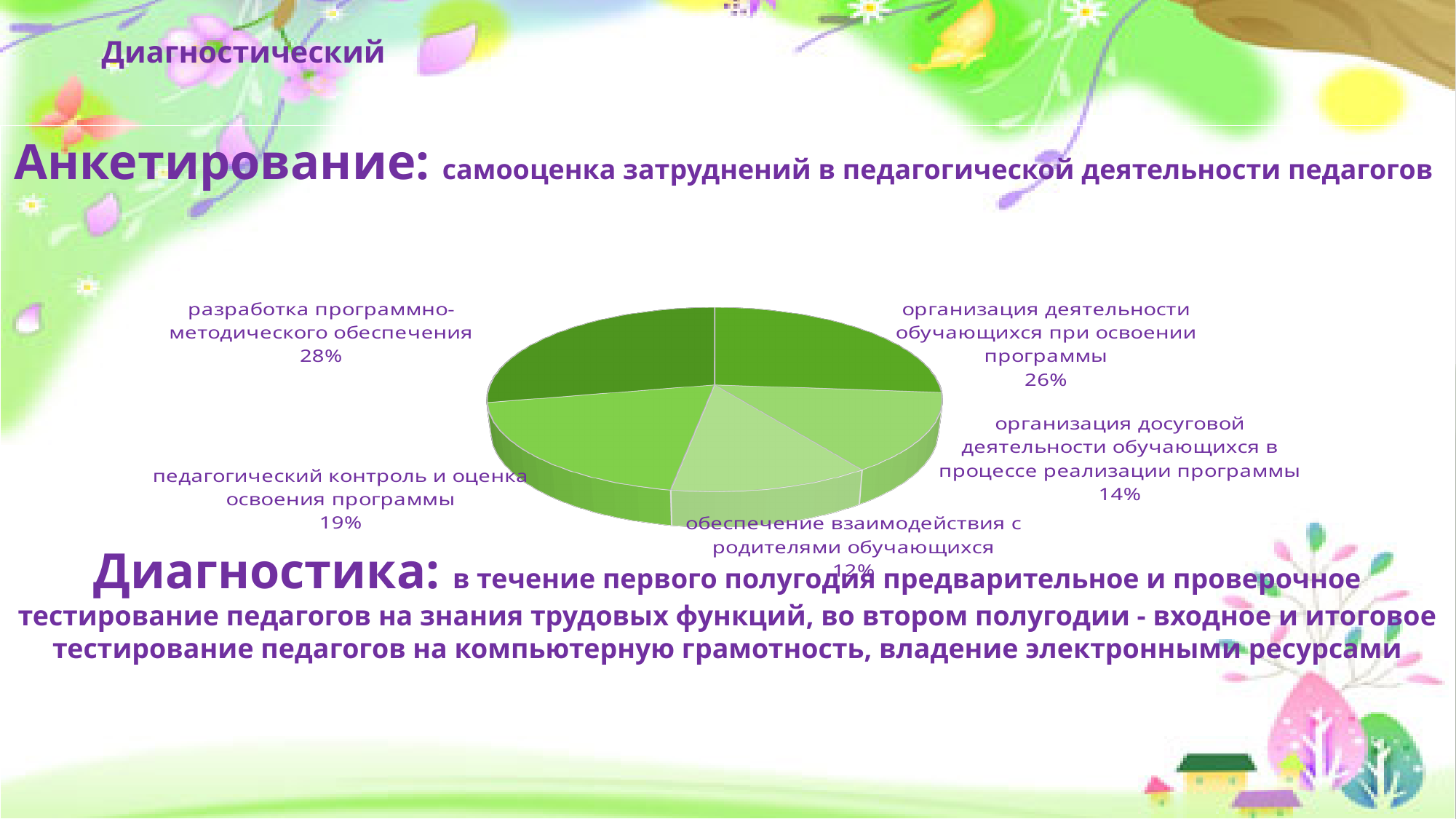
What percentage is shown for "организация деятельности обучающихся при освоении программы"? 26% What kind of chart is shown on the slide? pie chart Which category has the largest share of the pie? разработка программно-методического обеспечения What is the difference in percentage points between "разработка программно-методического обеспечения" and "организация деятельности обучающихся при освоении программы"? 2 Which category has the smallest share of the pie? обеспечение взаимодействия с родителями обучающихся What percentage is shown for "организация досуговой деятельности обучающихся в процессе реализации программы"? 14% What share of the pie is labelled "разработка программно-методического обеспечения"? 28% What is the difference in percentage points between "педагогический контроль и оценка освоения программы" and "организация досуговой деятельности обучающихся в процессе реализации программы"? 5 Which is larger: the share for "педагогический контроль и оценка освоения программы" or the share for "организация досуговой деятельности обучающихся в процессе реализации программы"? педагогический контроль и оценка освоения программы What percentage is shown for "педагогический контроль и оценка освоения программы"? 19% According to the heading above the chart, what does the survey (Анкетирование) measure? самооценка затруднений в педагогической деятельности педагогов How many slices does the pie chart have? 5